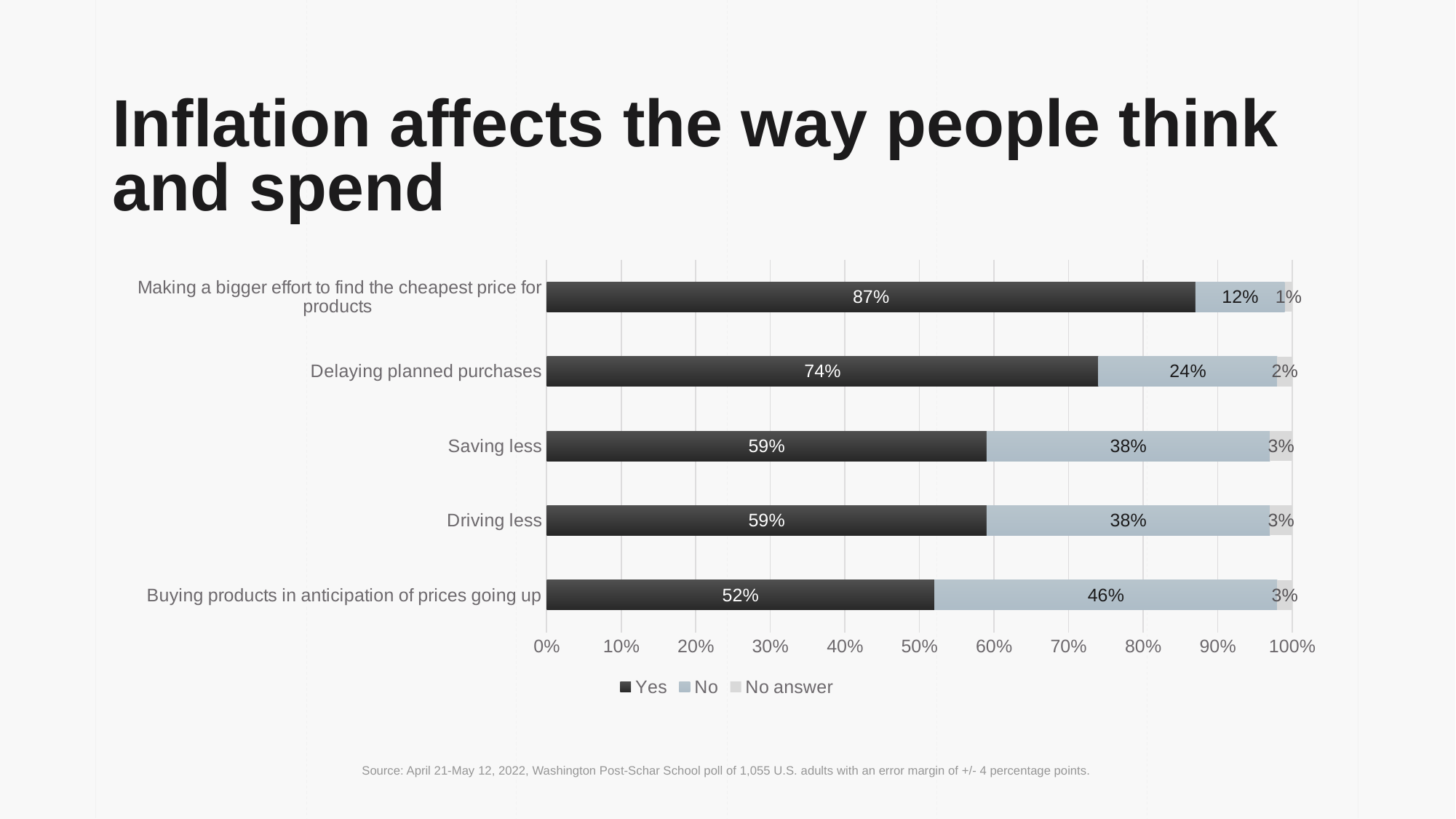
What is the No answer value for "Making a bigger effort to find the cheapest price for products"? 1% What percentage answered Yes to "Delaying planned purchases"? 74% What are the three legend entries on the chart? Yes, No, No answer What is the total of the stacked bar for "Saving less"? 100% What kind of chart is shown on the slide? Stacked bar chart Which category has the lowest Yes value? Buying products in anticipation of prices going up Which category has the highest Yes value? Making a bigger effort to find the cheapest price for products How many categories are shown on the chart? 5 Which is larger: the No value for "Saving less" or the No value for "Delaying planned purchases"? Saving less What is the No value for "Buying products in anticipation of prices going up"? 46% How many series does the legend list? 3 What is the difference between the Yes values for "Making a bigger effort to find the cheapest price for products" and "Delaying planned purchases"? 13%